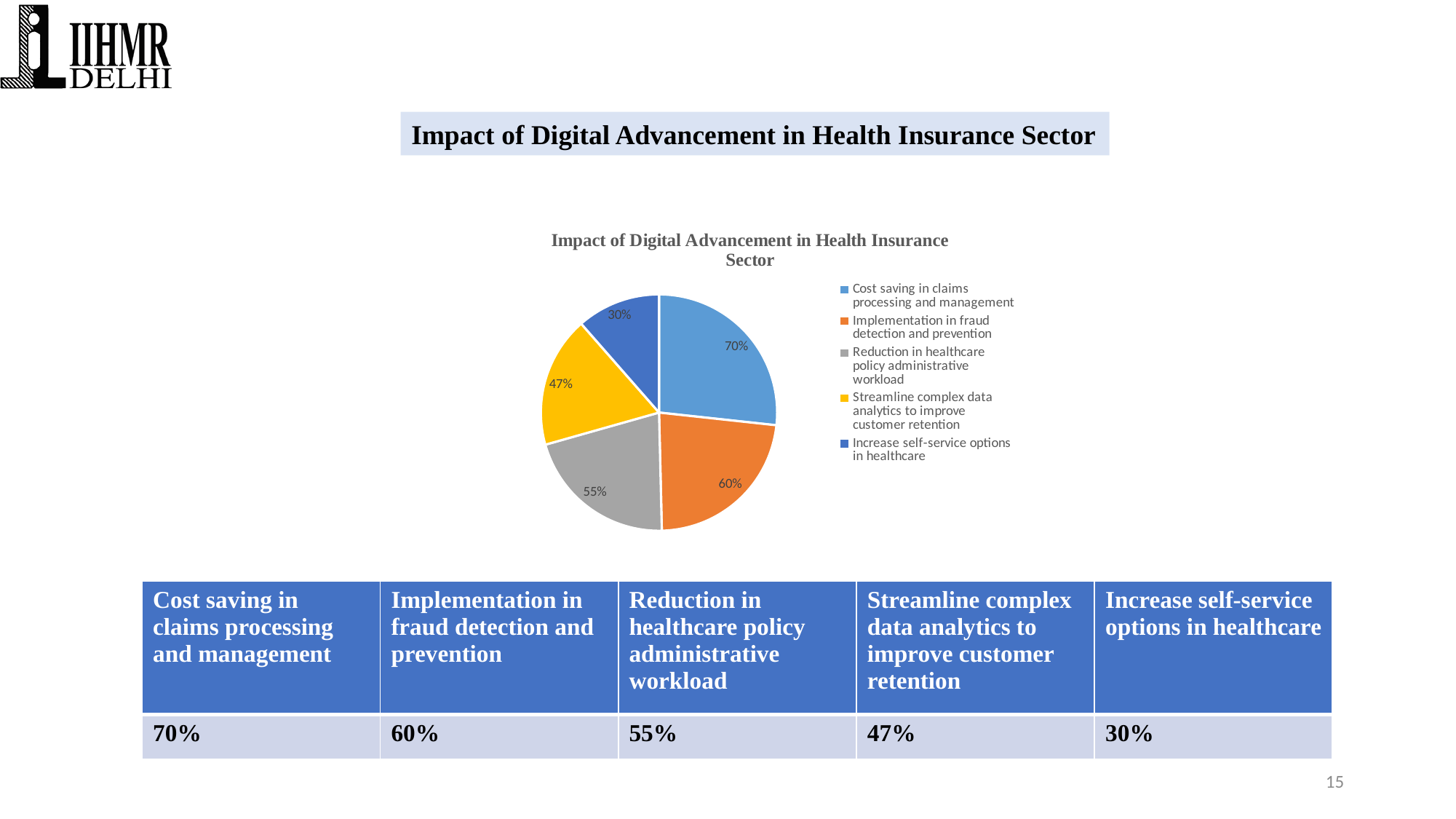
Which is larger: the value for Implementation in fraud detection and prevention or the value for Streamline complex data analytics to improve customer retention? Implementation in fraud detection and prevention Which category has the lowest value in the pie chart? Increase self-service options in healthcare What is the value labelled for Streamline complex data analytics to improve customer retention? 47% What kind of chart is shown on the slide? Pie chart What is the title of the pie chart? Impact of Digital Advancement in Health Insurance Sector What is the value labelled for Increase self-service options in healthcare? 30% Which category has the highest value in the pie chart? Cost saving in claims processing and management What is the value labelled for Implementation in fraud detection and prevention? 60% How many categories does the pie chart show? 5 What is the value labelled for Cost saving in claims processing and management? 70% What is the difference between the values for Cost saving in claims processing and management and Increase self-service options in healthcare? 40% What is the value labelled for Reduction in healthcare policy administrative workload? 55%